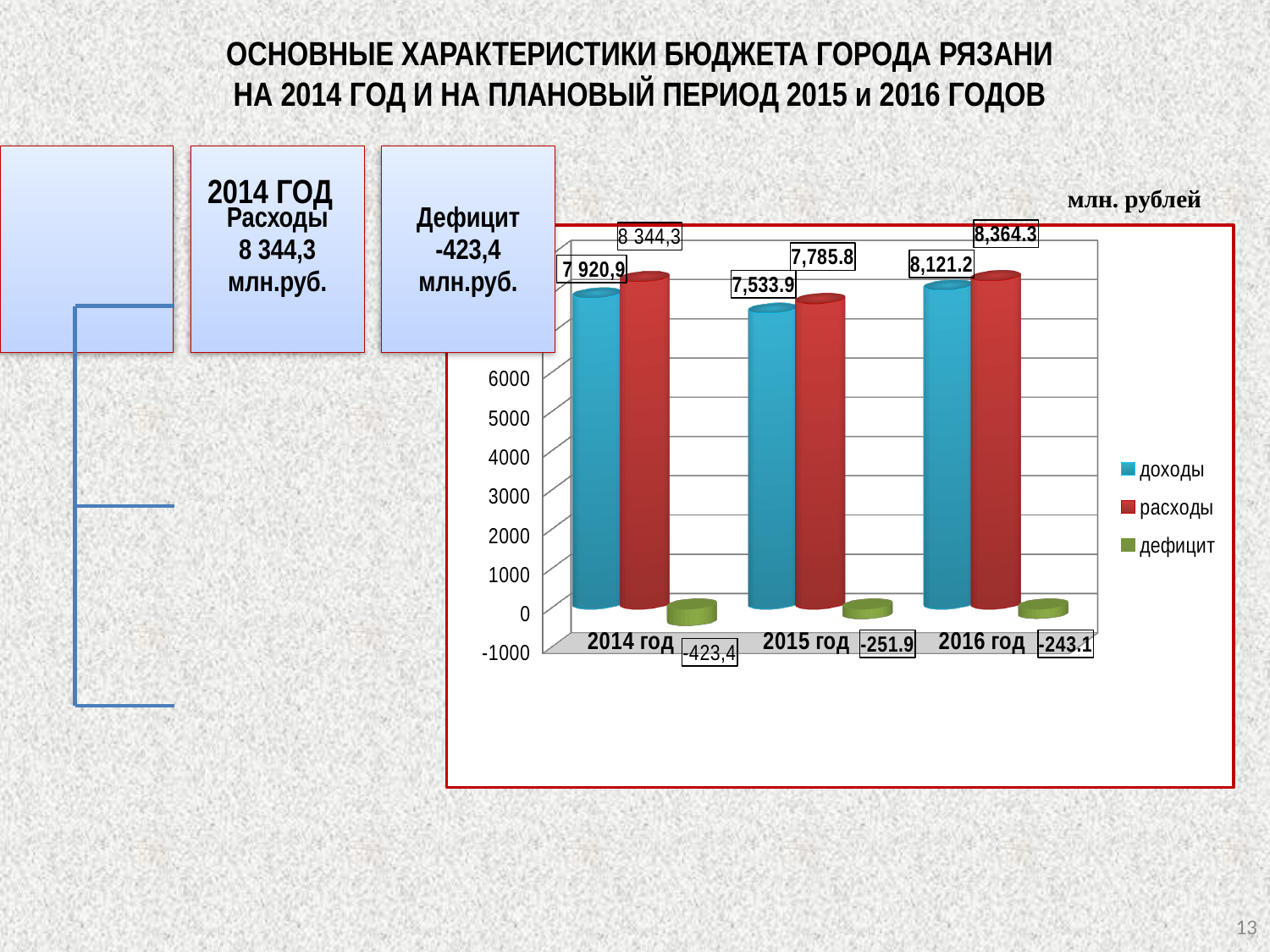
What is the value of доходы for 2016 год? 8,121.2 What is the difference between расходы and доходы for 2016 год? 243.1 What type of chart is shown on the slide? bar chart What is the value of расходы for 2015 год? 7,785.8 How many year categories are shown on the x axis of the chart? 3 What is the value of дефицит for 2016 год? -243.1 Which year has the highest расходы value? 2016 год What is the value of доходы for 2014 год? 7 920,9 What unit is stated above the chart? млн. рублей Which is larger for 2015 год: доходы or расходы? расходы How many series does the chart legend list? 3 Which year has the lowest доходы value? 2015 год